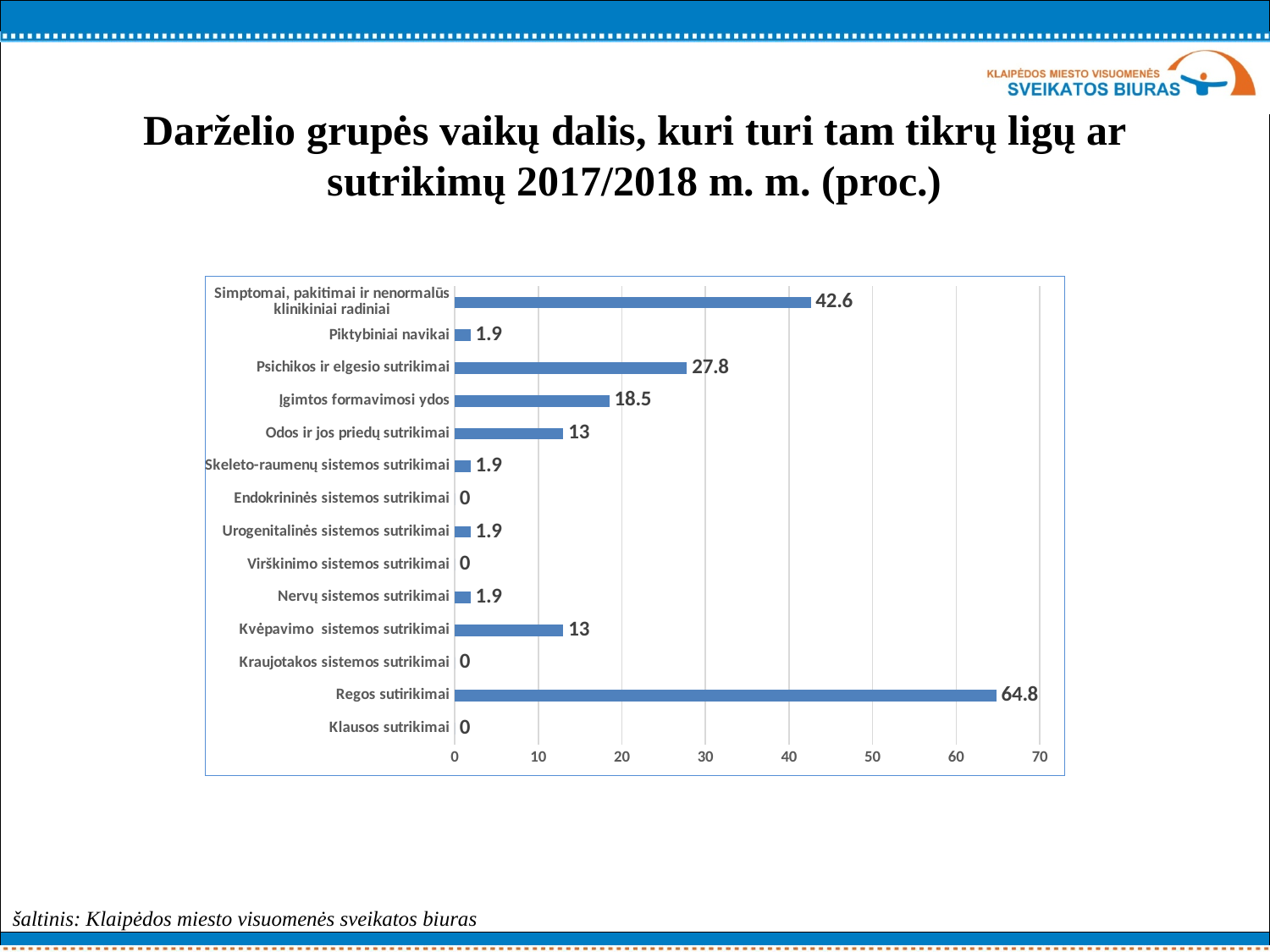
What kind of chart is shown on the slide? Bar chart What is the maximum value shown on the x axis? 70 What is the value for Regos sutirikimai? 64.8 Which is larger, Psichikos ir elgesio sutrikimai or Įgimtos formavimosi ydos? Psichikos ir elgesio sutrikimai Which category has the highest value? Regos sutirikimai How many categories are shown in the chart? 14 What is the value for Psichikos ir elgesio sutrikimai? 27.8 What is the value for Kvėpavimo sistemos sutrikimai? 13 How many categories have a value of 0? 4 What is the value for Įgimtos formavimosi ydos? 18.5 What is the difference between Regos sutirikimai and Simptomai, pakitimai ir nenormalūs klinikiniai radiniai? 22.2 What is the value for Simptomai, pakitimai ir nenormalūs klinikiniai radiniai? 42.6